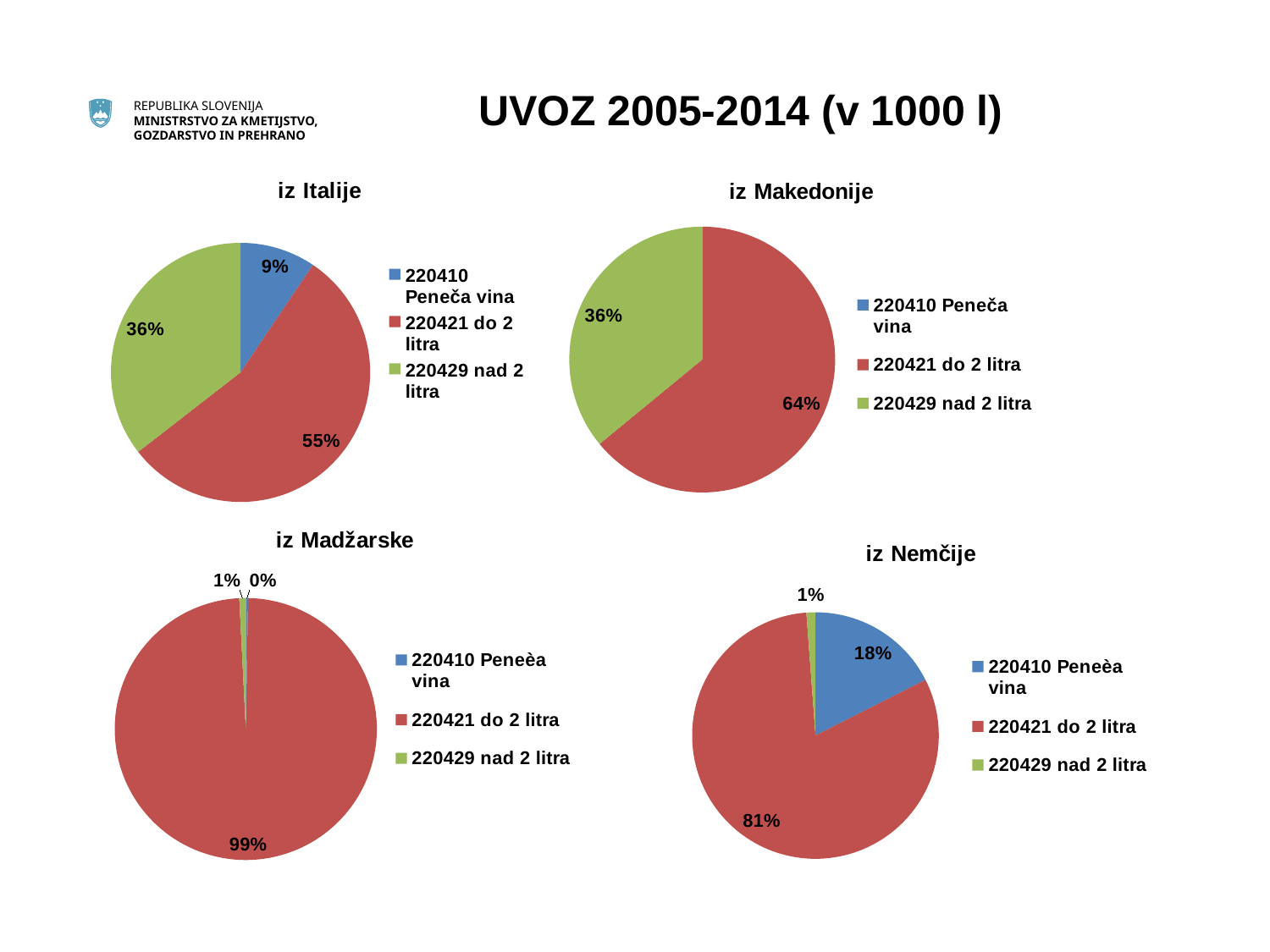
In the 'iz Italije' pie chart, which category has the smallest slice? 220410 Peneča vina In the 'iz Nemčije' pie chart, which is larger, the share of 220410 Peneča vina or the share of 220429 nad 2 litra? 220410 Peneča vina In the 'iz Nemčije' pie chart, what share does 220410 Peneča vina have? 18% In the 'iz Italije' pie chart, what share does 220421 do 2 litra have? 55% In the 'iz Italije' pie chart, which category has the largest slice? 220421 do 2 litra In the 'iz Italije' pie chart, what share does 220410 Peneča vina have? 9% What type of chart is used for 'iz Makedonije'? Pie chart In the 'iz Makedonije' pie chart, what is the difference between the shares of 220421 do 2 litra and 220429 nad 2 litra? 28 percentage points How many entries does the legend of the 'iz Nemčije' chart list? 3